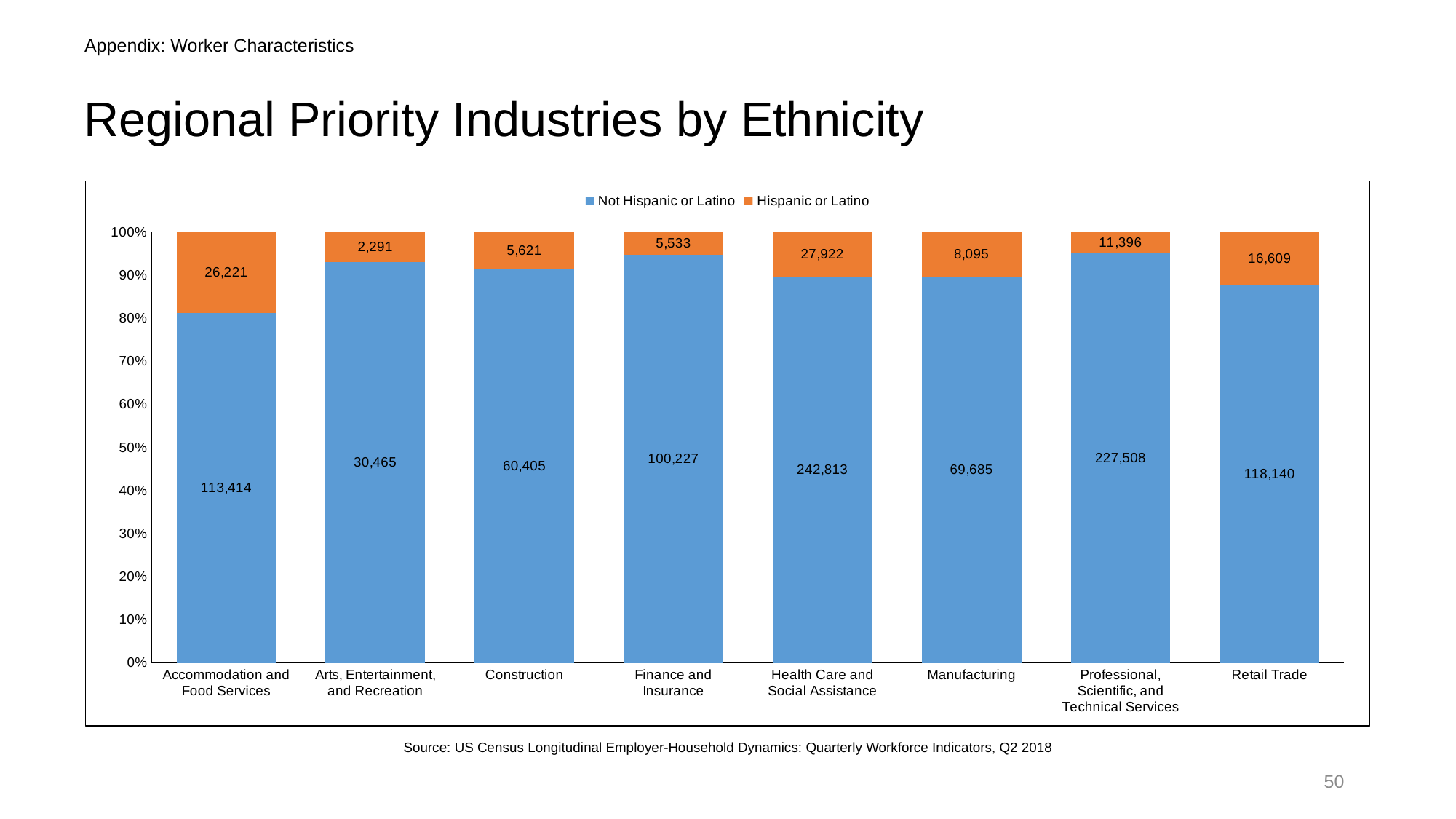
How many industries are shown on the x axis? 8 What is the Hispanic or Latino value for Professional, Scientific, and Technical Services? 11,396 What is the difference between the Not Hispanic or Latino values for Retail Trade and Accommodation and Food Services? 4,726 What is the Hispanic or Latino value for Accommodation and Food Services? 26,221 Which industry has the lowest Hispanic or Latino value? Arts, Entertainment, and Recreation How many series does the legend list? 2 What is the Not Hispanic or Latino value for Health Care and Social Assistance? 242,813 Which industry has the highest Not Hispanic or Latino value? Health Care and Social Assistance What kind of chart is shown on the slide? Stacked bar chart Which is larger, the Hispanic or Latino value for Retail Trade or for Manufacturing? Retail Trade Is the Not Hispanic or Latino share of the Accommodation and Food Services bar greater or less than 90%? less What is the total of the two values in the Health Care and Social Assistance bar? 270,735